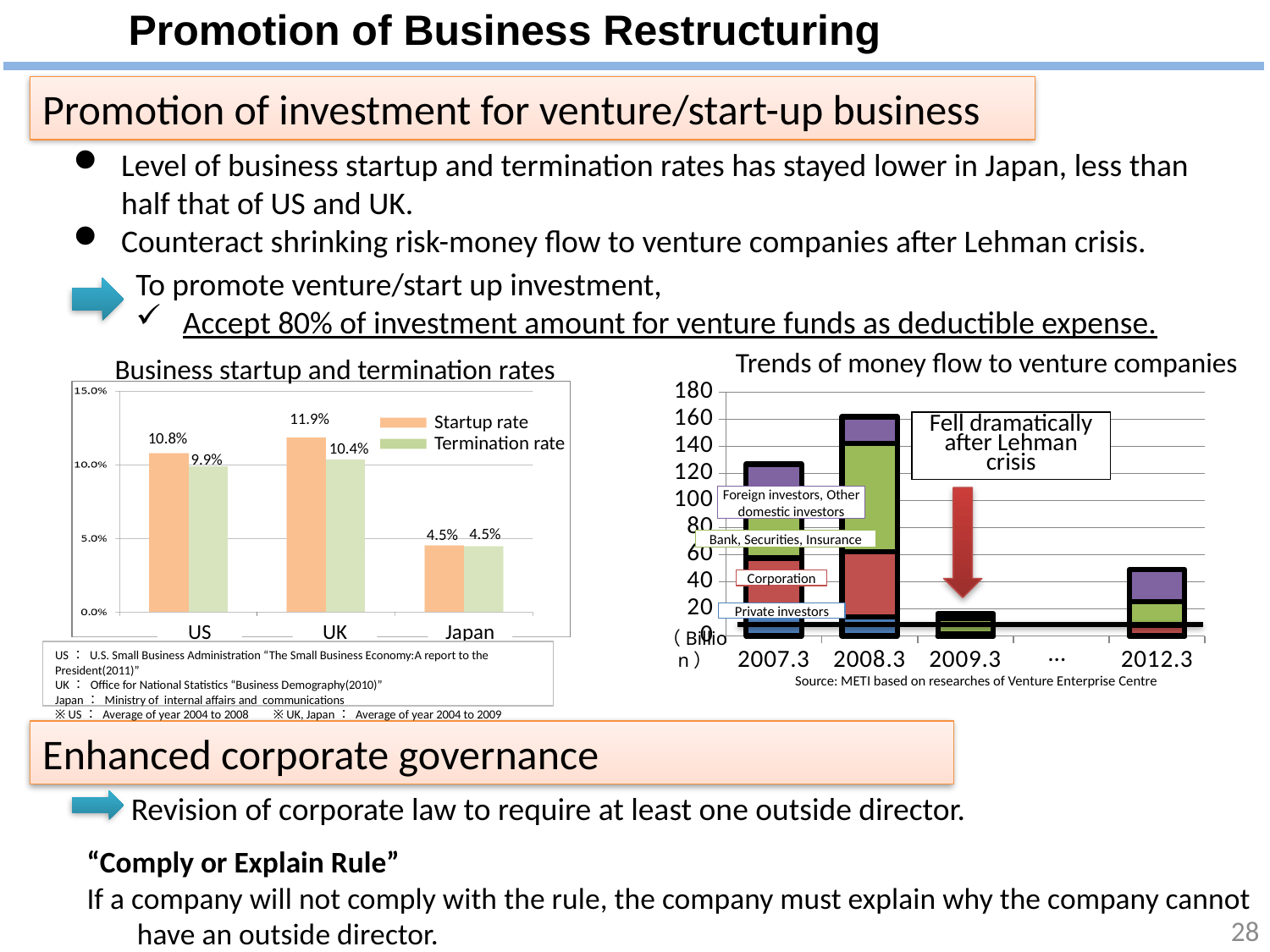
In the 'Business startup and termination rates' chart, which is larger, the startup rate for the US or the startup rate for the UK? UK In the 'Trends of money flow to venture companies' chart, which year has the highest total? 2008.3 In the 'Business startup and termination rates' chart, what is the termination rate for Japan? 4.5% What kind of chart is 'Trends of money flow to venture companies'? Stacked bar chart In the 'Business startup and termination rates' chart, which country has the lowest termination rate? Japan How many series does the legend of the 'Business startup and termination rates' chart list? 2 In the 'Business startup and termination rates' chart, which country has the highest startup rate? UK In the 'Trends of money flow to venture companies' chart, is the total for 2008.3 greater or less than 140? greater In the 'Business startup and termination rates' chart, what is the difference between the UK startup rate and the UK termination rate? 1.5% How many countries are shown in the 'Business startup and termination rates' chart? 3 In the 'Business startup and termination rates' chart, what is the startup rate for the US? 10.8% In the 'Business startup and termination rates' chart, what is the termination rate for the UK? 10.4%